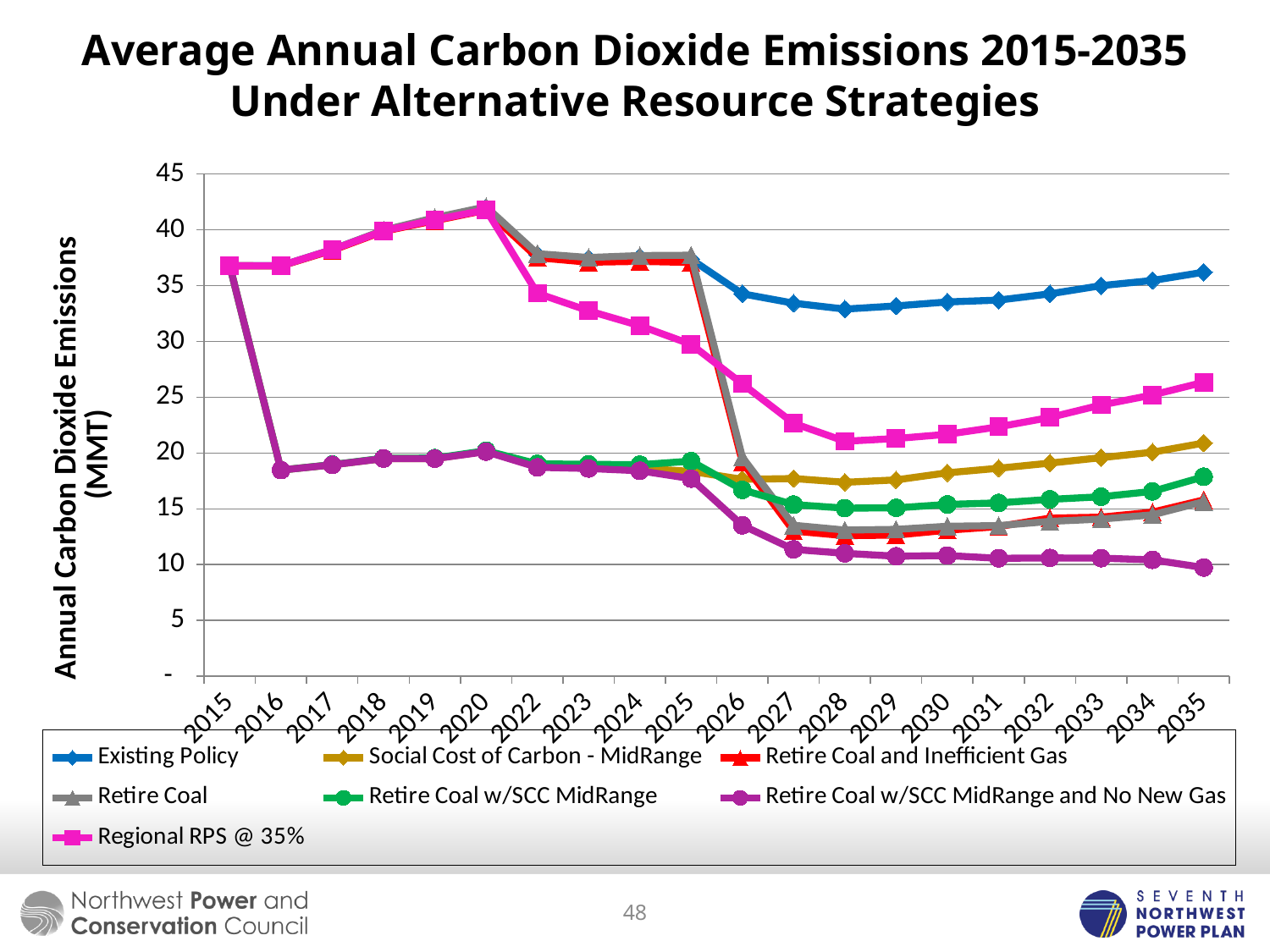
Which series has the highest value in 2035? Existing Policy What kind of chart is shown on the slide? line chart How many years are labelled along the x axis? 20 Is the value for Social Cost of Carbon - MidRange in 2035 greater or less than 25? less Is the value for Retire Coal w/SCC MidRange and No New Gas in 2035 greater or less than 15? less Which series has the lowest value in 2035? Retire Coal w/SCC MidRange and No New Gas Is the value for Existing Policy in 2035 greater or less than 30? greater How many series does the legend list? 7 Does the Regional RPS @ 35% line rise or fall between 2020 and 2028? fall What is the label on the y axis? Annual Carbon Dioxide Emissions (MMT) In 2035, which is larger: Existing Policy or Regional RPS @ 35%? Existing Policy